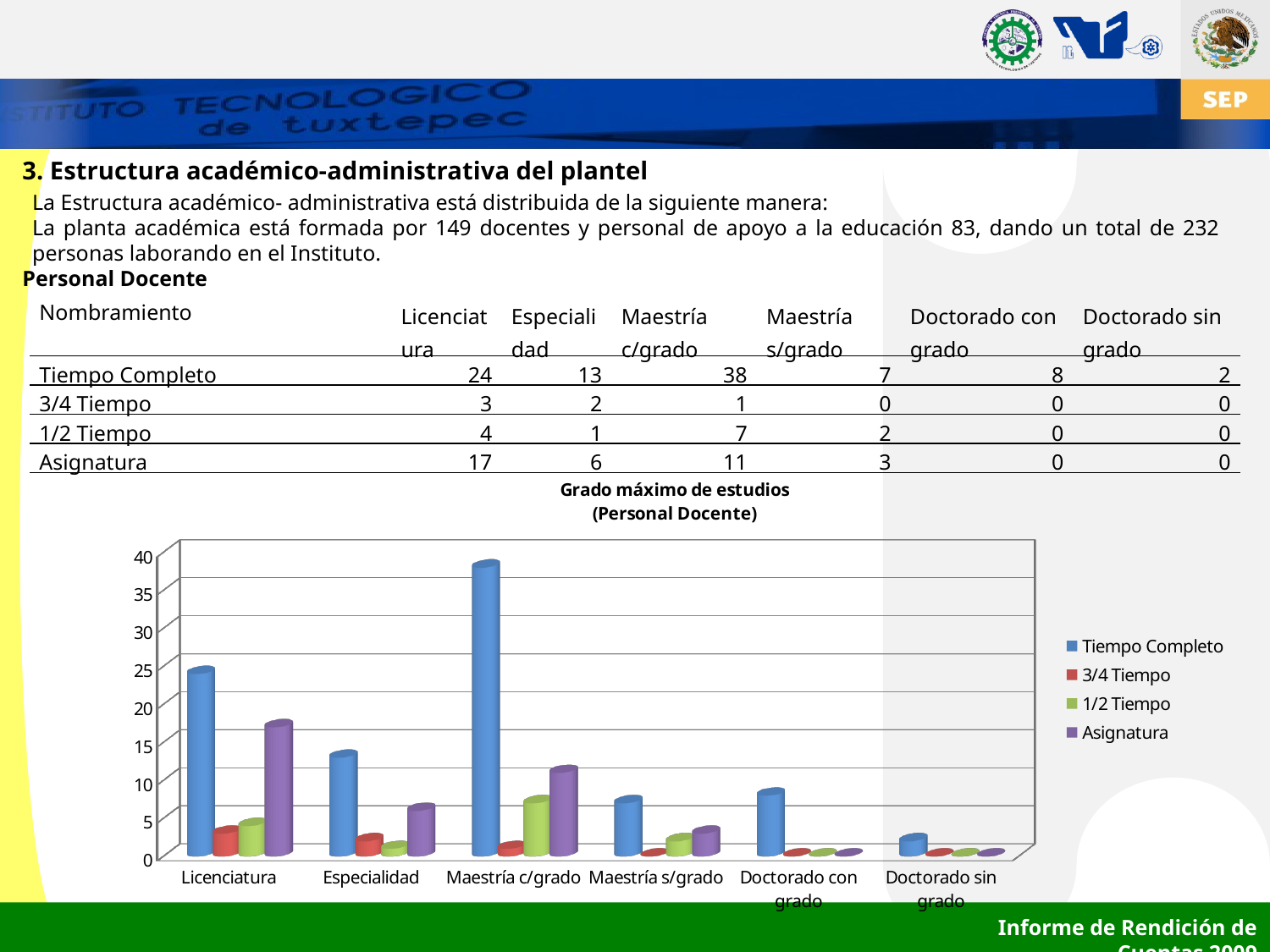
What kind of chart is shown on the slide? bar chart How many series does the chart legend list? 4 What is the difference between the Tiempo Completo values for Maestría c/grado and Licenciatura? 14 What is the title of the chart? Grado máximo de estudios (Personal Docente) For the Tiempo Completo series, which category has the lowest value? Doctorado sin grado Is the value for Tiempo Completo in the Licenciatura category greater or less than 20? greater In the Licenciatura category, which is larger: Tiempo Completo or Asignatura? Tiempo Completo What is the value for Asignatura in the Licenciatura category? 17 In the Maestría c/grado category, which is larger: 1/2 Tiempo or Asignatura? Asignatura For the Tiempo Completo series, which category has the highest value? Maestría c/grado What is the value for Tiempo Completo in the Maestría c/grado category? 38 How many categories are shown along the x axis of the chart? 6